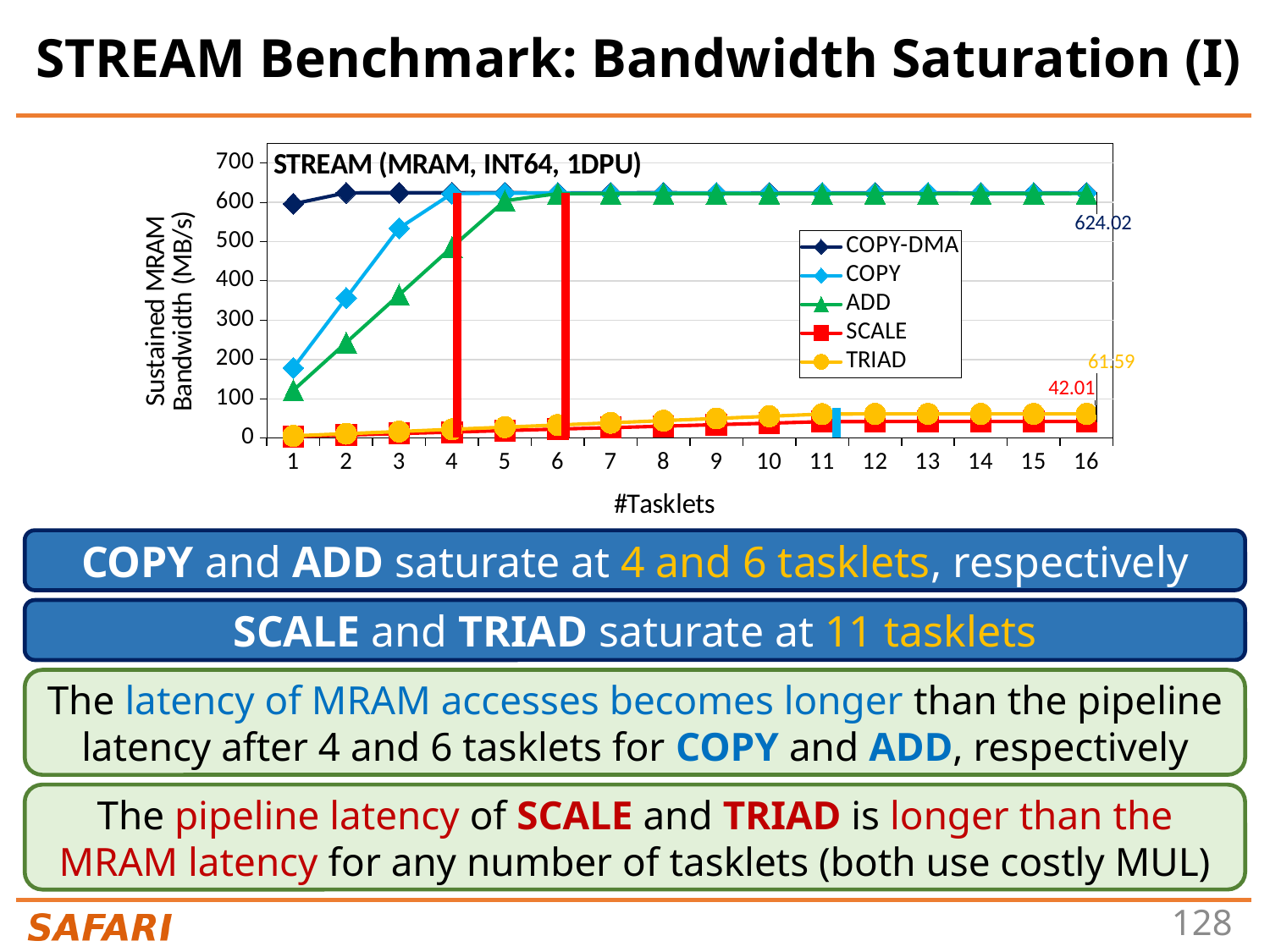
Is the value for ADD at 1 tasklet greater or less than 200? less What is the title shown inside the chart area? STREAM (MRAM, INT64, 1DPU) How many series does the chart legend list? 5 What is the labelled value for TRIAD at 16 tasklets? 61.59 How many #Tasklets values are plotted along the x axis? 16 What kind of chart is shown on the slide? line chart At 16 tasklets, which has the larger labelled value, SCALE or TRIAD? TRIAD What is the difference between the labelled TRIAD and SCALE values at 16 tasklets? 19.58 Which series has the lowest value at 16 tasklets? SCALE What value is labelled for the top (COPY-DMA) line at 16 tasklets? 624.02 Is the value for COPY-DMA at 1 tasklet greater or less than 500? greater What is the labelled value for SCALE at 16 tasklets? 42.01